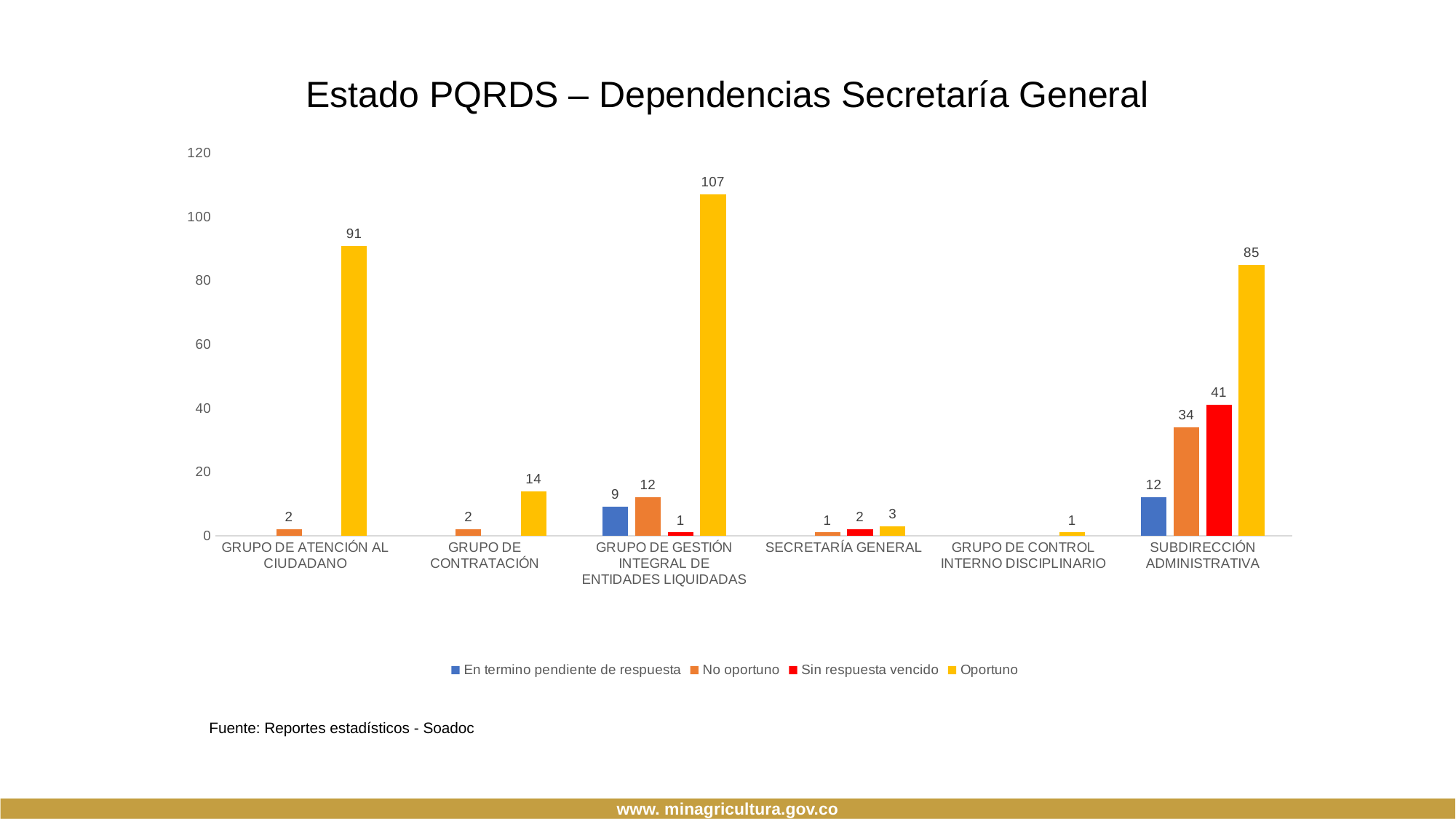
Which category has the lowest Oportuno value? GRUPO DE CONTROL INTERNO DISCIPLINARIO How many categories are shown on the x axis? 6 What is the Oportuno value for GRUPO DE CONTRATACIÓN? 14 Which category has the highest Oportuno value? GRUPO DE GESTIÓN INTEGRAL DE ENTIDADES LIQUIDADAS What is the difference between the Oportuno values for GRUPO DE ATENCIÓN AL CIUDADANO and SUBDIRECCIÓN ADMINISTRATIVA? 6 How many series does the legend list? 4 What kind of chart is shown on the slide? Bar chart What is the Sin respuesta vencido value for SUBDIRECCIÓN ADMINISTRATIVA? 41 Is the Oportuno value for GRUPO DE ATENCIÓN AL CIUDADANO greater or less than 80? greater What is the Oportuno value for GRUPO DE GESTIÓN INTEGRAL DE ENTIDADES LIQUIDADAS? 107 What is the No oportuno value for SUBDIRECCIÓN ADMINISTRATIVA? 34 Which is larger for SUBDIRECCIÓN ADMINISTRATIVA: No oportuno or Sin respuesta vencido? Sin respuesta vencido